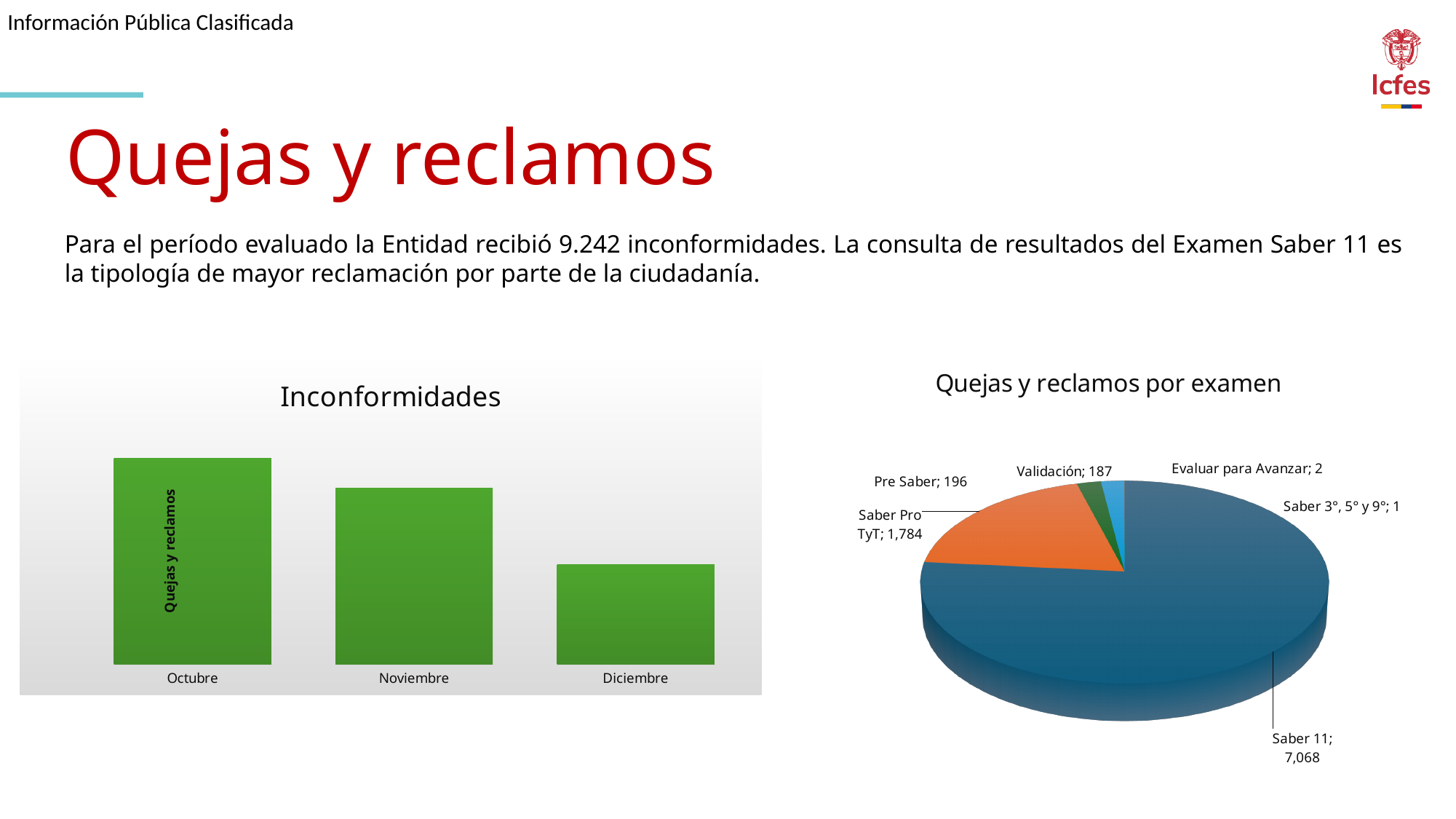
What kind of chart is the "Inconformidades" chart? bar chart In the "Quejas y reclamos por examen" chart, what is the difference between Saber 11 and Saber Pro TyT? 5,284 In the "Quejas y reclamos por examen" chart, what is the value for Saber 11? 7,068 In the "Inconformidades" chart, which month has the lowest value? Diciembre In the "Inconformidades" chart, which is larger, Noviembre or Diciembre? Noviembre How many months are shown in the "Inconformidades" chart? 3 In the "Inconformidades" chart, which month has the highest value? Octubre In the "Quejas y reclamos por examen" chart, what is the value for Saber Pro TyT? 1,784 What kind of chart is "Quejas y reclamos por examen"? pie chart In the "Inconformidades" chart, do the values rise or fall from Octubre to Diciembre? fall How many slices does the "Quejas y reclamos por examen" pie chart have? 6 In the "Quejas y reclamos por examen" chart, which exam has the smallest slice? Saber 3°, 5° y 9°